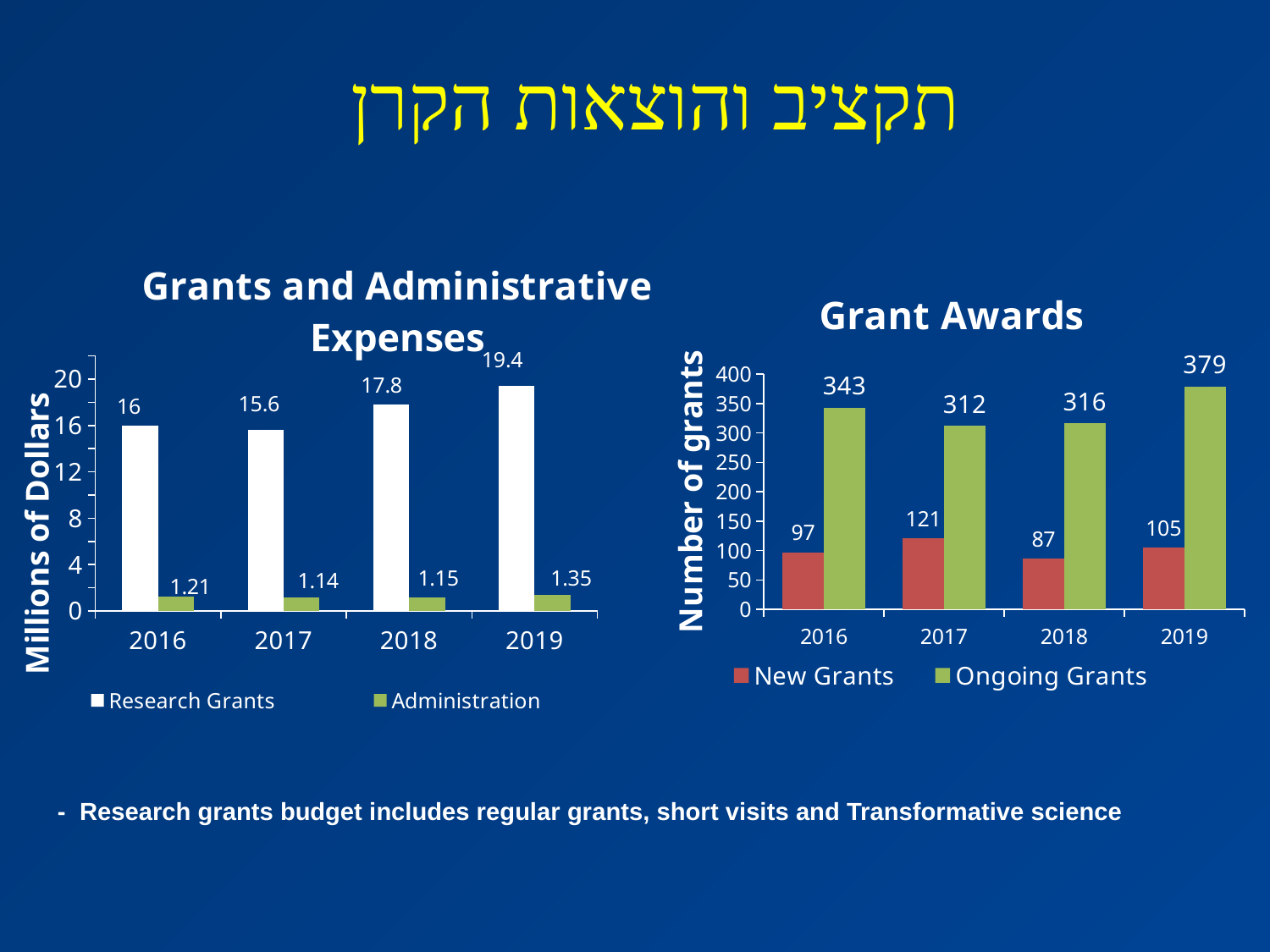
In the 'Grants and Administrative Expenses' chart, what is the difference between Research Grants in 2019 and 2018? 1.6 In the 'Grant Awards' chart, which year has the lowest number of New Grants? 2018 In the 'Grants and Administrative Expenses' chart, which year has the lowest Research Grants value? 2017 In the 'Grant Awards' chart, which is larger: Ongoing Grants in 2017 or Ongoing Grants in 2018? Ongoing Grants in 2018 In the 'Grant Awards' chart, what is the difference between Ongoing Grants in 2019 and 2016? 36 What kind of chart is the 'Grant Awards' chart? Bar chart In the 'Grants and Administrative Expenses' chart, how many series does the legend list? 2 In the 'Grant Awards' chart, what is the number of New Grants in 2017? 121 In the 'Grant Awards' chart, what is the number of Ongoing Grants in 2019? 379 In the 'Grants and Administrative Expenses' chart, what is the y-axis label? Millions of Dollars In the 'Grants and Administrative Expenses' chart, what is the value for Administration in 2017? 1.14 In the 'Grants and Administrative Expenses' chart, what is the value for Research Grants in 2019? 19.4